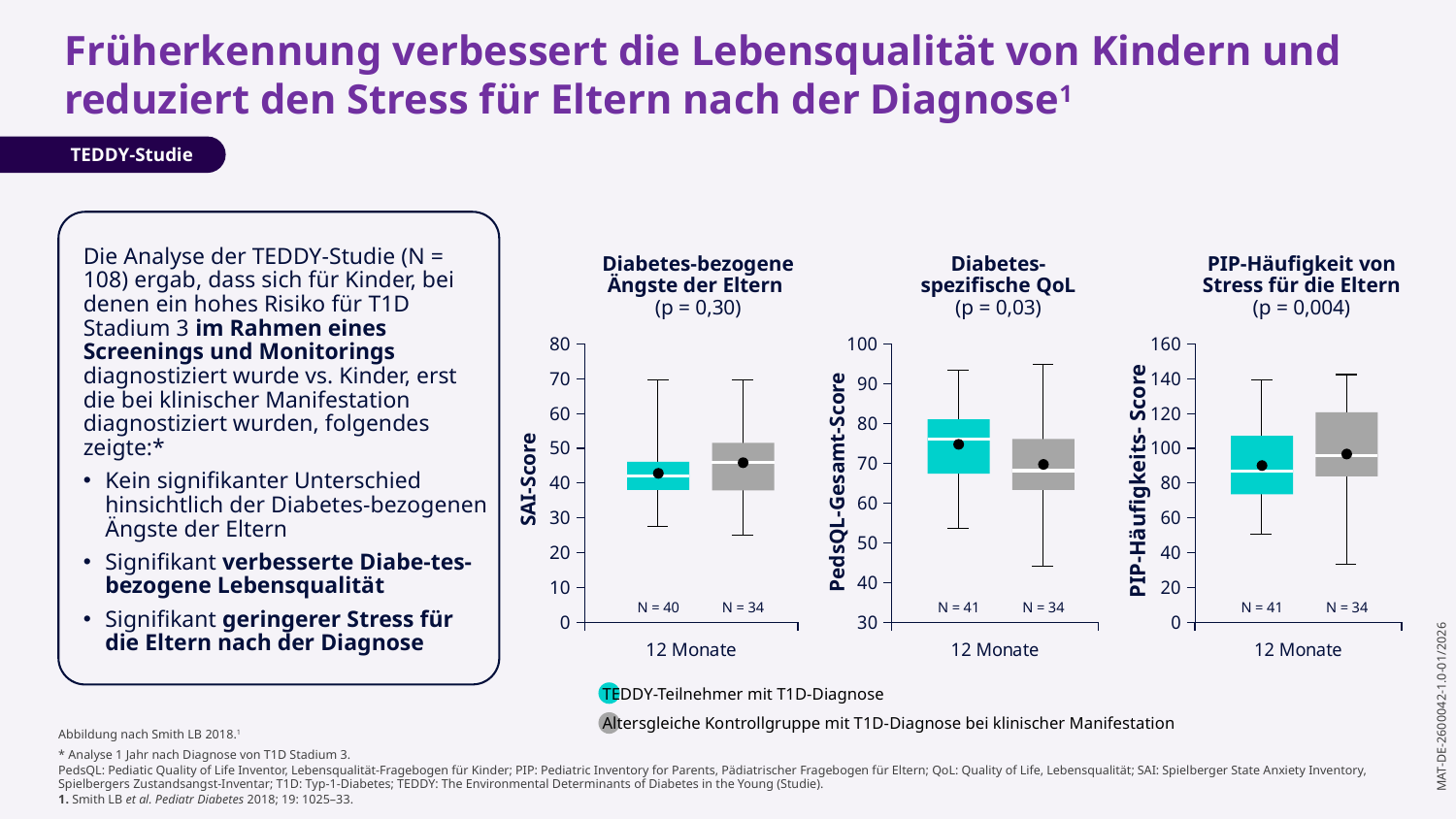
What p-value is shown for the chart 'Diabetes-spezifische QoL'? p = 0,03 In the chart 'Diabetes-spezifische QoL', what is the N for the age-matched control group (grey box)? N = 34 In the chart 'Diabetes-bezogene Ängste der Eltern', is the mean (dot) for the TEDDY participants greater or less than 50? less In the chart 'PIP-Häufigkeit von Stress für die Eltern', is the mean (dot) for the TEDDY participants greater or less than 100? less In the chart 'Diabetes-spezifische QoL', is the mean (dot) for the TEDDY participants greater or less than 70? greater How many groups does the legend below the charts list? 2 What kind of chart is used for the three plots on the slide? Box plot In the chart 'PIP-Häufigkeit von Stress für die Eltern', what is the N for the TEDDY participants (teal box)? N = 41 What p-value is shown for the chart 'PIP-Häufigkeit von Stress für die Eltern'? p = 0,004 In the chart 'Diabetes-spezifische QoL', which group has the higher mean (dot): the TEDDY participants or the control group? TEDDY participants What is the y-axis label of the middle chart? PedsQL-Gesamt-Score In the chart 'Diabetes-bezogene Ängste der Eltern', what is the N for the TEDDY participants (teal box)? N = 40